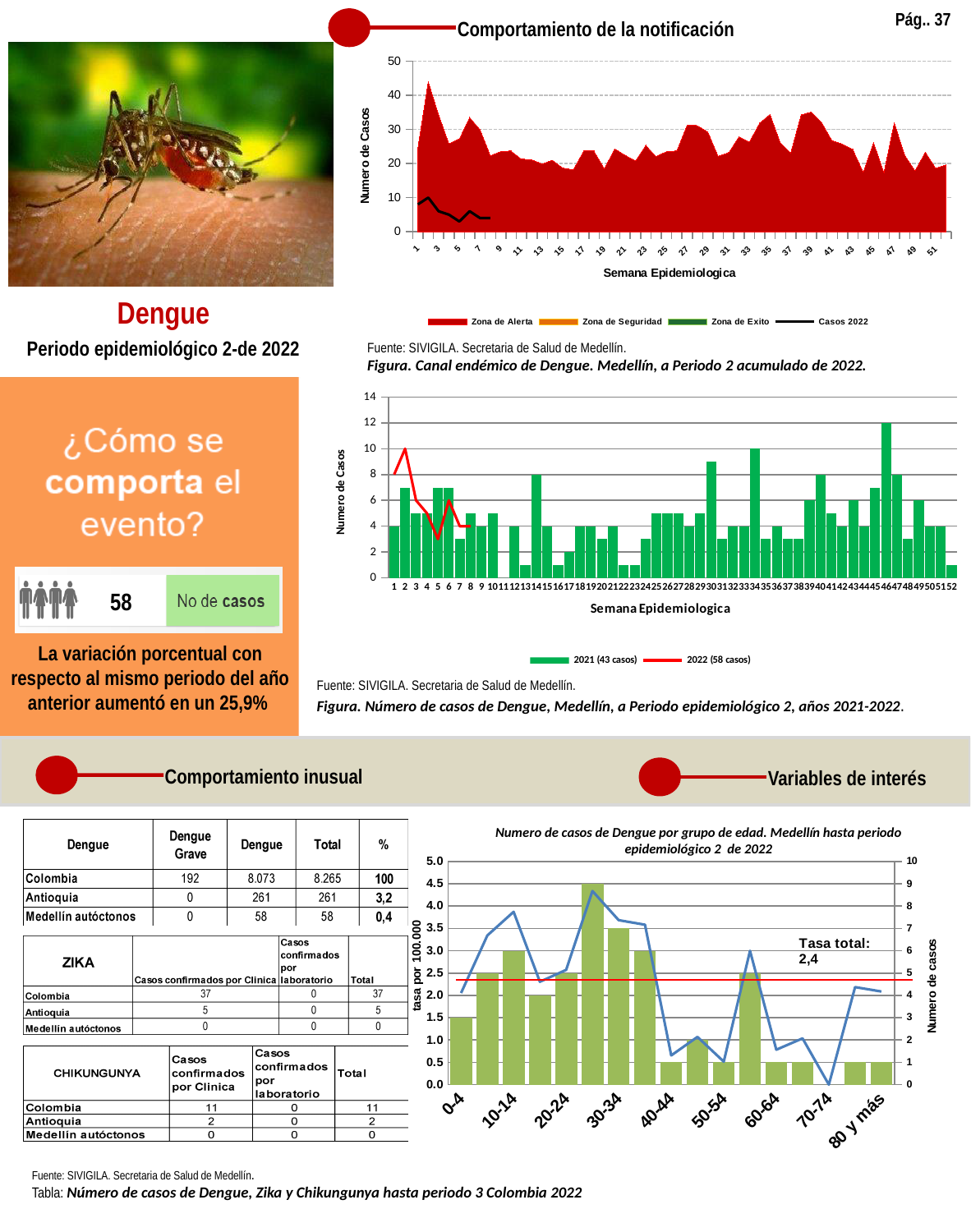
In the chart titled 'Figura. Número de casos de Dengue, Medellín, a Periodo epidemiológico 2, años 2021-2022', what is the 2021 value at week 46? 12 In the chart titled 'Numero de casos de Dengue por grupo de edad', what is the 'Tasa total' shown on the chart? 2,4 In the chart titled 'Figura. Número de casos de Dengue, Medellín, a Periodo epidemiológico 2, años 2021-2022', what kind of chart is used for the 2021 series? bar chart In the chart titled 'Figura. Número de casos de Dengue, Medellín, a Periodo epidemiológico 2, años 2021-2022', how many series does the legend list? 2 In the chart titled 'Figura. Número de casos de Dengue, Medellín, a Periodo epidemiológico 2, años 2021-2022', which week has the highest number of 2021 cases? 46 In the chart titled 'Figura. Canal endémico de Dengue', how many entries does the legend list? 4 In the chart titled 'Figura. Canal endémico de Dengue', is the 'Casos 2022' value at week 8 greater or less than 10? less In the chart titled 'Figura. Canal endémico de Dengue', what is the highest value shown on the y axis? 50 In the chart titled 'Figura. Número de casos de Dengue, Medellín, a Periodo epidemiológico 2, años 2021-2022', what is the 2022 value at week 2? 10